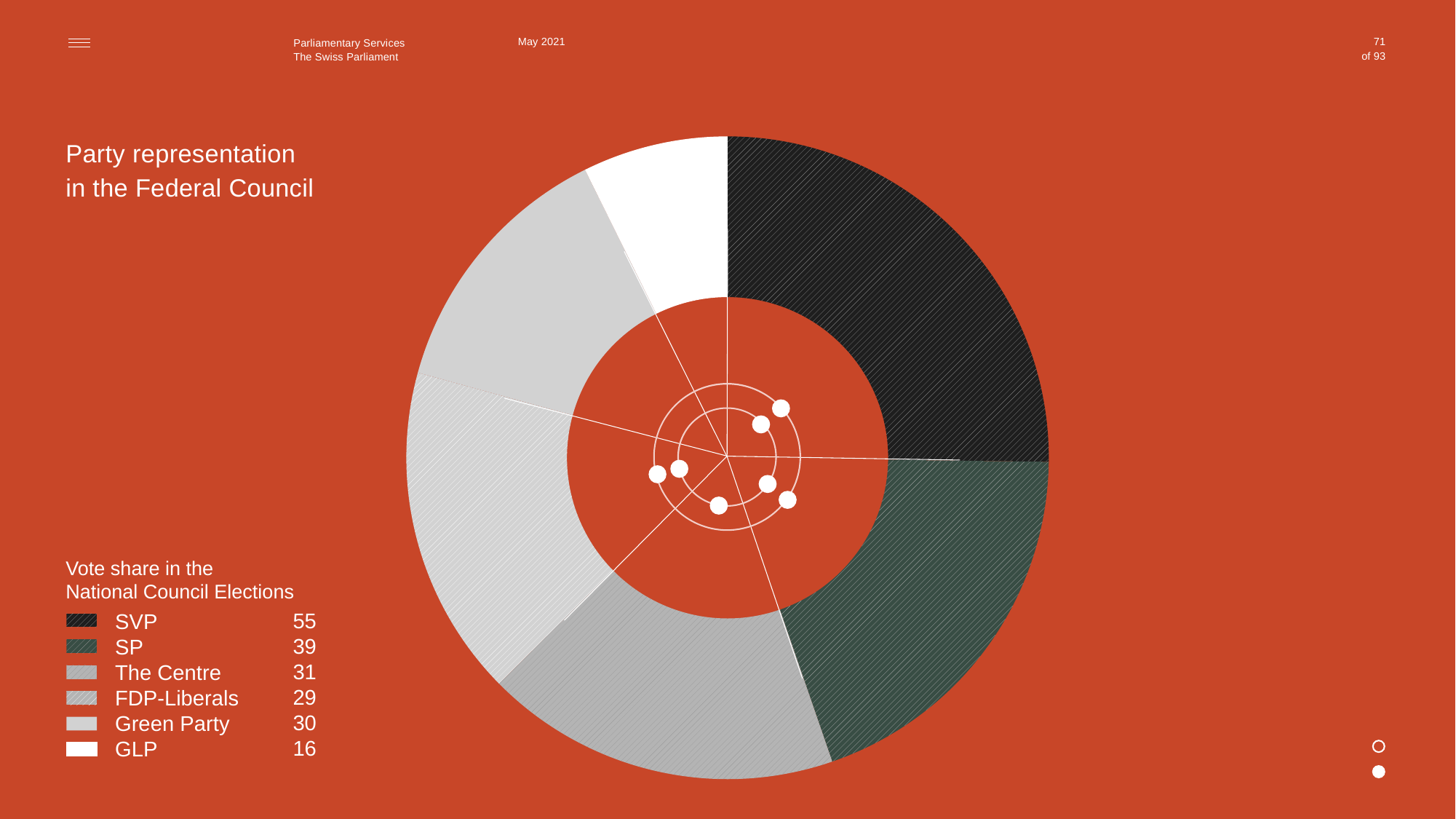
What is the title of the chart on the slide? Party representation in the Federal Council What kind of chart is shown on the slide? doughnut chart What is the vote share value shown for The Centre? 31 What is the difference between the vote share of Green Party and FDP-Liberals? 1 How many parties are shown in the chart? 6 How many entries does the legend list? 6 What is the vote share value shown for GLP? 16 What is the vote share value shown for SVP? 55 Which party has the highest vote share in the chart? SVP What is the difference between the vote share of SVP and SP? 16 Which has a larger vote share, SP or The Centre? SP Which party has the lowest vote share in the chart? GLP